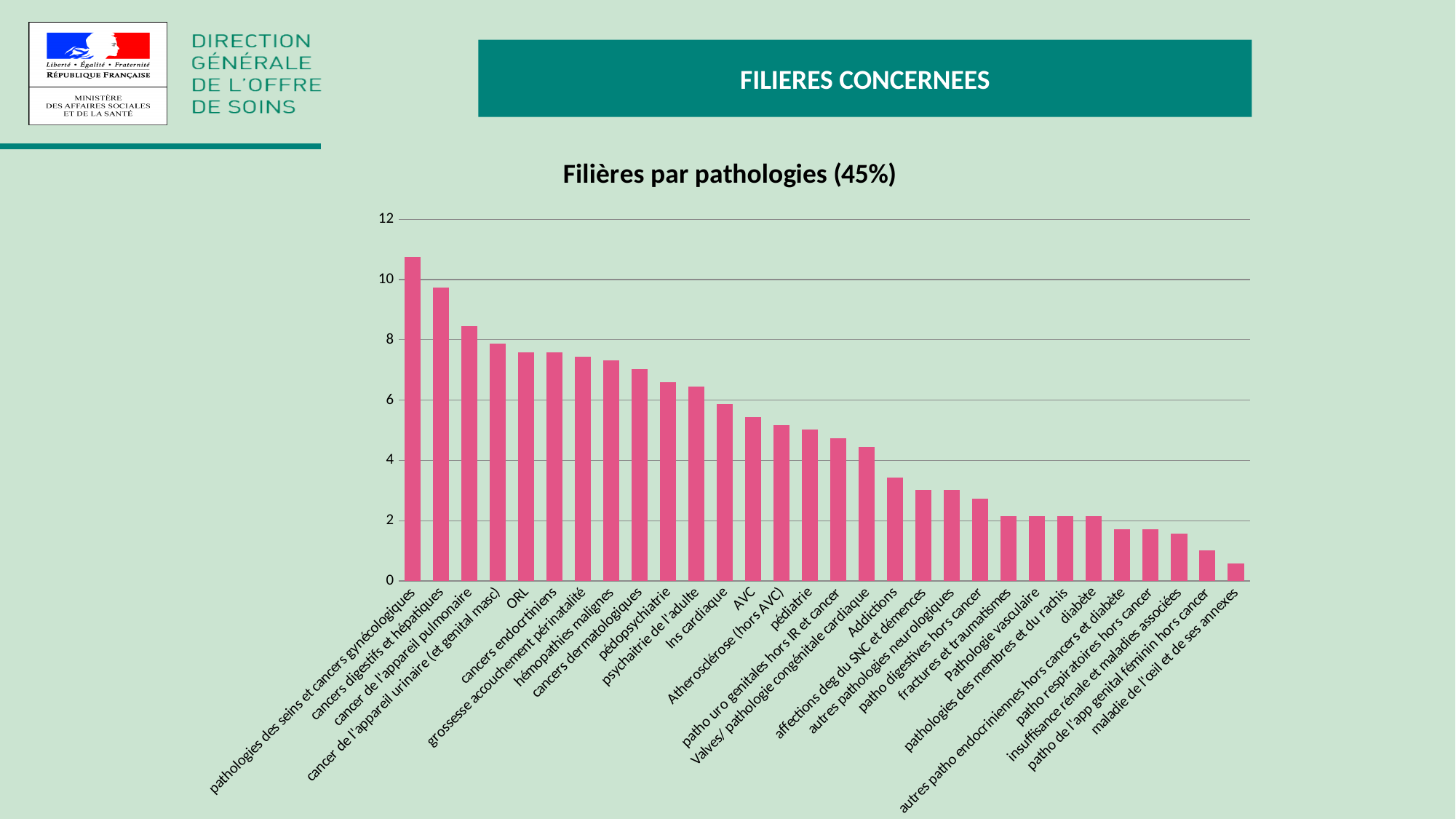
Is the value for cancers digestifs et hépatiques greater or less than 10? less Is the value for AVC greater or less than 6? less What is the title of the chart? Filières par pathologies (45%) What kind of chart is shown on the slide? bar chart Is the value for pathologies des seins et cancers gynécologiques greater or less than 10? greater Which category has the highest value? pathologies des seins et cancers gynécologiques Which is larger, the value for Addictions or the value for diabète? Addictions Which category has the lowest value? maladie de l'œil et de ses annexes Do the values rise or fall from left to right along the x axis? fall Which is larger, the value for pédopsychiatrie or the value for AVC? pédopsychiatrie How many categories (bars) are plotted in the chart? 30